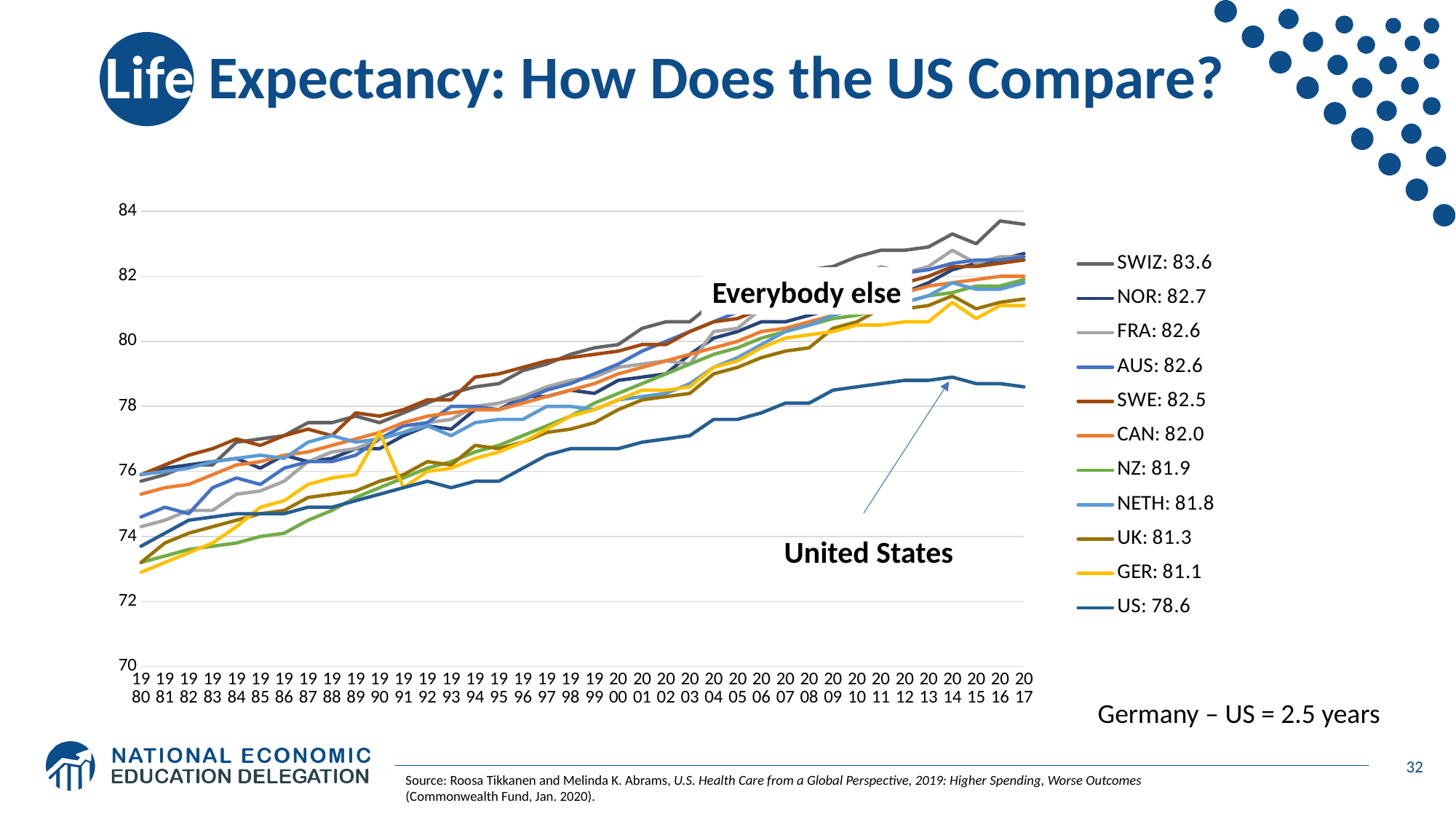
Does the US line generally rise or fall from 1980 to 2017? rise What kind of chart is shown on the slide? line chart Is the value for the US line in 1980 greater or less than 74? less What is the difference between the legend values for SWIZ and US? 5.0 What value does the legend show for US? 78.6 What value does the legend show for SWIZ? 83.6 How many series does the legend list? 11 Which country has the highest value in the legend? SWIZ How many years are shown along the x axis? 38 Which has the larger legend value, NOR or CAN? NOR Which country has the lowest value in the legend? US What value does the legend show for GER? 81.1